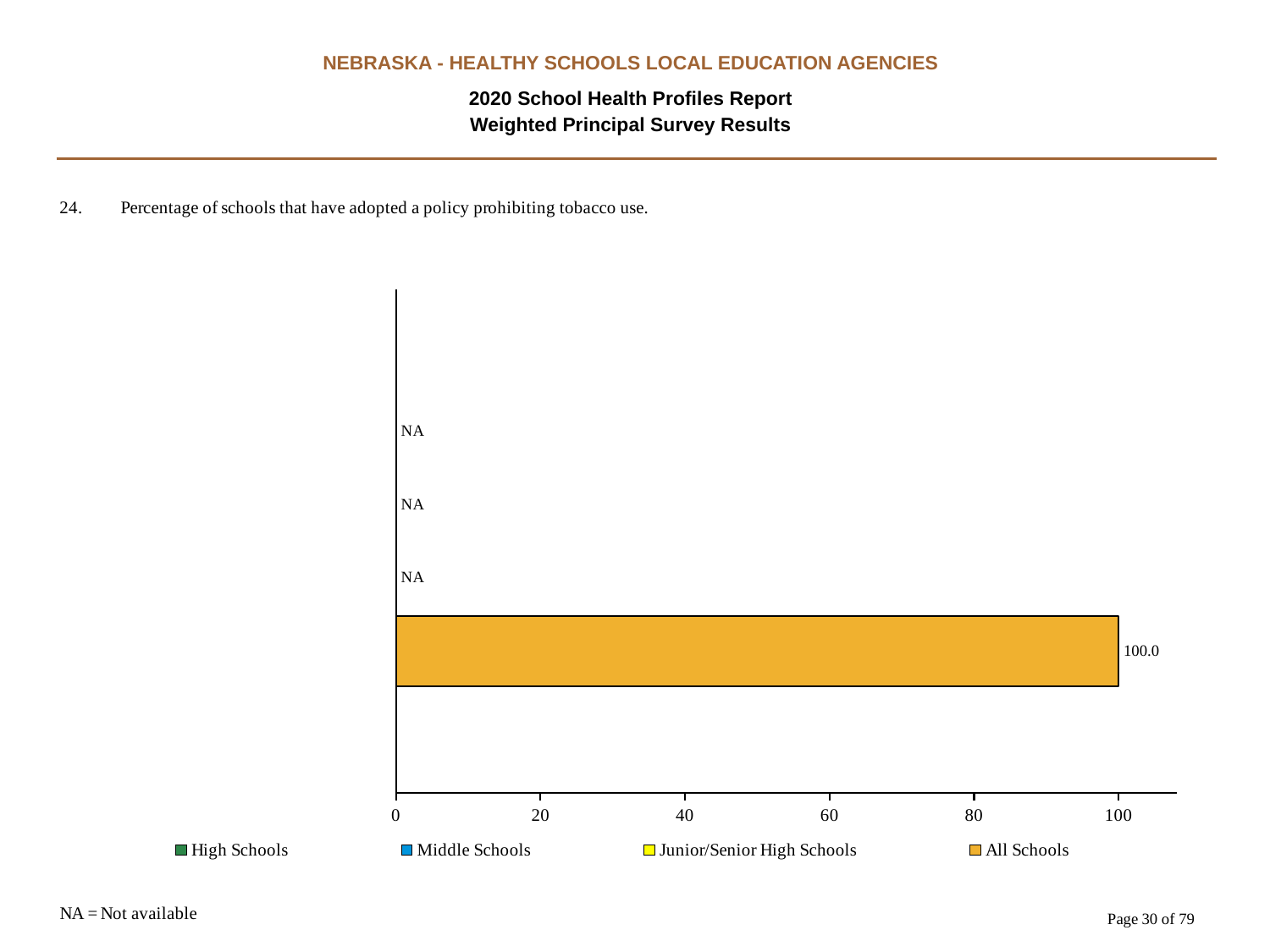
What does NA stand for according to the slide? Not available What kind of chart is this? bar chart How many series does the legend list? 4 What is shown for Middle Schools? NA What is shown for High Schools? NA Which series has a plotted bar with a value? All Schools Is the value for All Schools greater or less than 80? greater What is the value for All Schools? 100.0 How many series are marked NA? 3 What is shown for Junior/Senior High Schools? NA What is the highest tick value shown on the x axis? 100